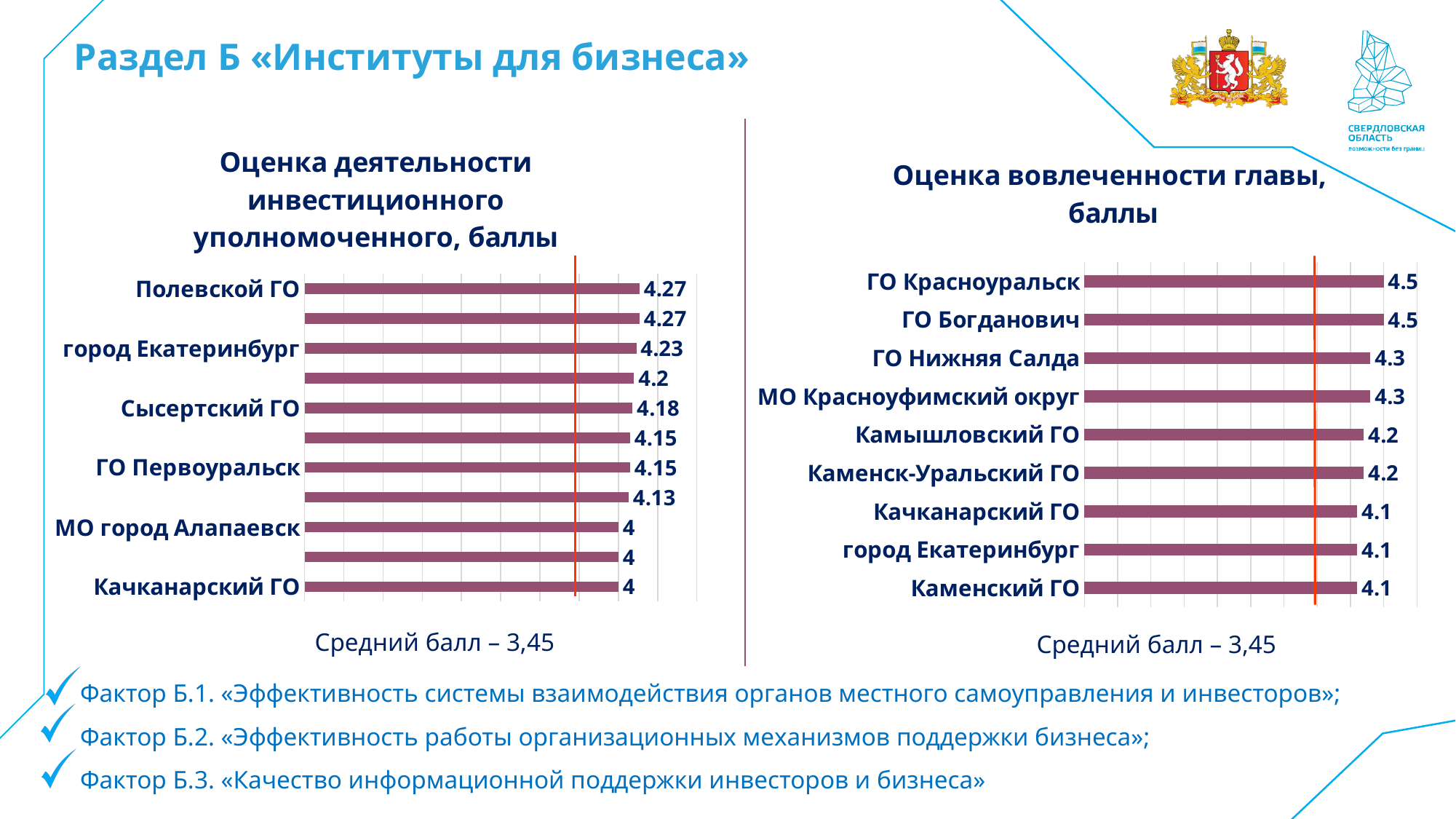
In the chart 'Оценка вовлеченности главы, баллы', what is the value for ГО Красноуральск? 4.5 What kind of chart is 'Оценка вовлеченности главы, баллы'? Bar chart In the chart 'Оценка вовлеченности главы, баллы', what is the value for Каменский ГО? 4.1 In the chart 'Оценка вовлеченности главы, баллы', which is larger: the value for ГО Нижняя Салда or the value for Качканарский ГО? ГО Нижняя Салда How many bars are shown in the chart 'Оценка вовлеченности главы, баллы'? 9 In the chart 'Оценка деятельности инвестиционного уполномоченного, баллы', what is the value for Сысертский ГО? 4.18 In the chart 'Оценка деятельности инвестиционного уполномоченного, баллы', what is the value for город Екатеринбург? 4.23 In the chart 'Оценка деятельности инвестиционного уполномоченного, баллы', what is the difference between the values for Полевской ГО and ГО Первоуральск? 0.12 In the chart 'Оценка вовлеченности главы, баллы', what is the difference between the values for ГО Богданович and город Екатеринбург? 0.4 In the chart 'Оценка деятельности инвестиционного уполномоченного, баллы', what is the value for Полевской ГО? 4.27 In the chart 'Оценка деятельности инвестиционного уполномоченного, баллы', which is larger: the value for Полевской ГО or the value for МО город Алапаевск? Полевской ГО In the chart 'Оценка вовлеченности главы, баллы', what is the value for Камышловский ГО? 4.2